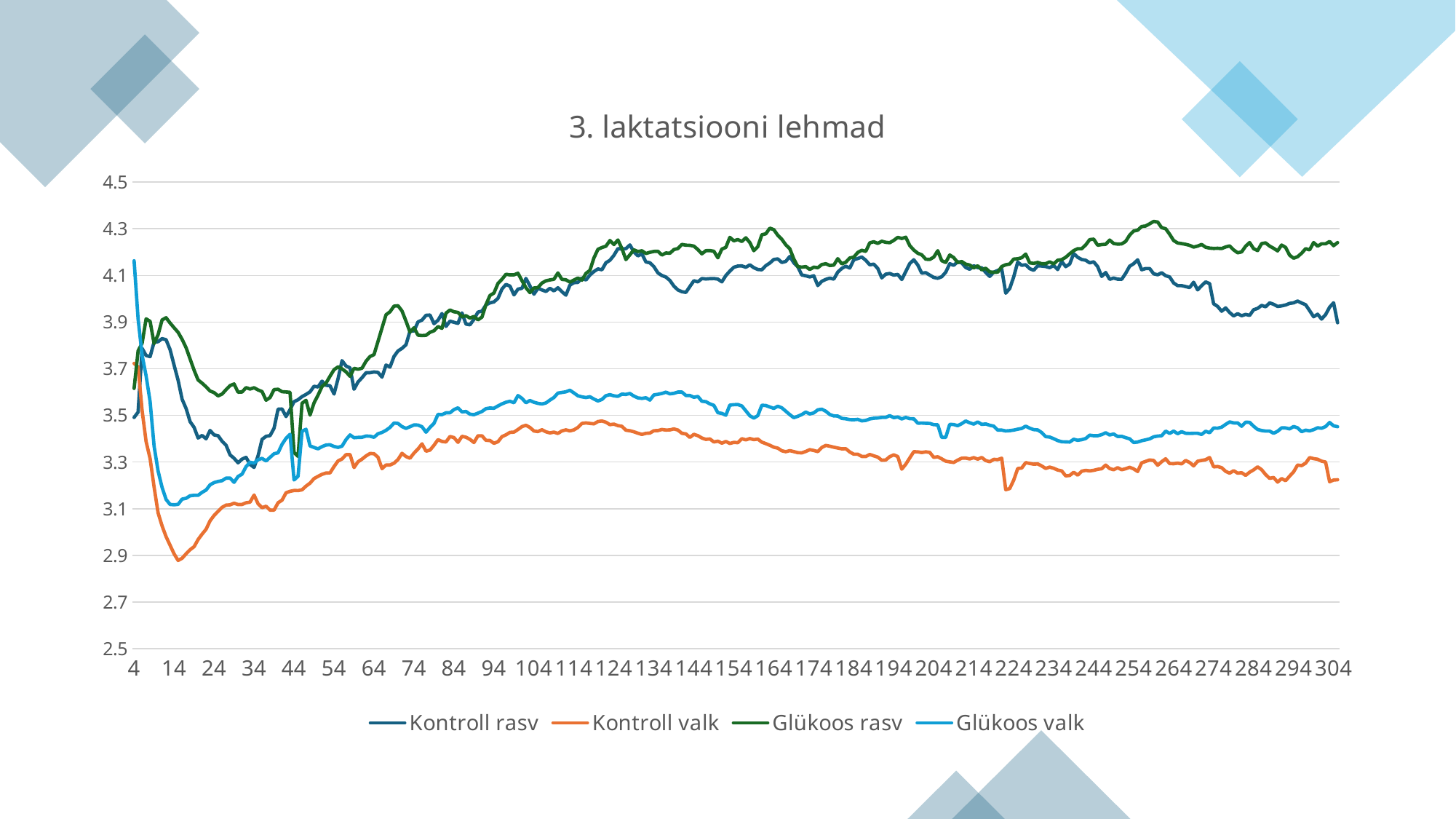
Is the value for Kontroll valk at x = 14 greater or less than 3.1? less Which series has the lowest value at x = 304? Kontroll valk Does the Kontroll valk line rise or fall between x = 14 and x = 124? rise What kind of chart is shown on the slide? line chart Does the Kontroll rasv line rise or fall between x = 254 and x = 304? fall At x = 304, which is higher: Glükoos rasv or Kontroll rasv? Glükoos rasv Is the value for Glükoos valk at x = 124 greater or less than 3.5? greater Is the value for Glükoos rasv at x = 264 greater or less than 4.1? greater What is the title of the chart? 3. laktatsiooni lehmad How many series does the legend list? 4 At x = 304, which is higher: Glükoos valk or Kontroll valk? Glükoos valk